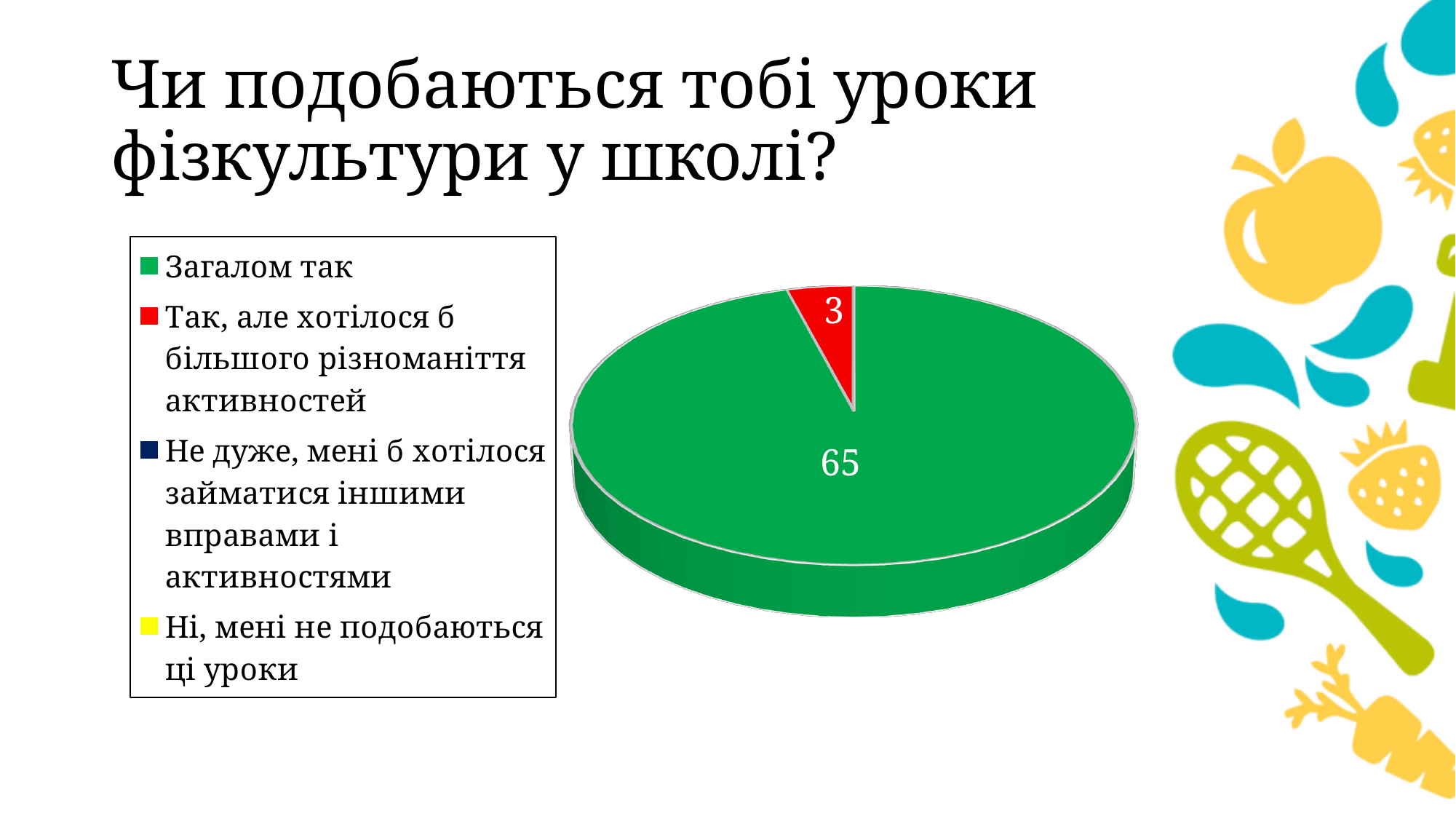
What is the title of the slide containing the chart? Чи подобаються тобі уроки фізкультури у школі? What colour represents "Загалом так" in the pie chart? Green What kind of chart is shown on the slide? Pie chart What value is shown for the "Так, але хотілося б більшого різноманіття активностей" slice? 3 How many categories are listed in the chart's legend? 4 What is the difference between the values of the "Загалом так" slice and the "Так, але хотілося б більшого різноманіття активностей" slice? 62 Which of the labelled slices is the smallest? Так, але хотілося б більшого різноманіття активностей What value is shown for the "Загалом так" slice of the pie chart? 65 Which is larger: the value for "Загалом так" or the value for "Так, але хотілося б більшого різноманіття активностей"? Загалом так Which category has the largest slice in the pie chart? Загалом так